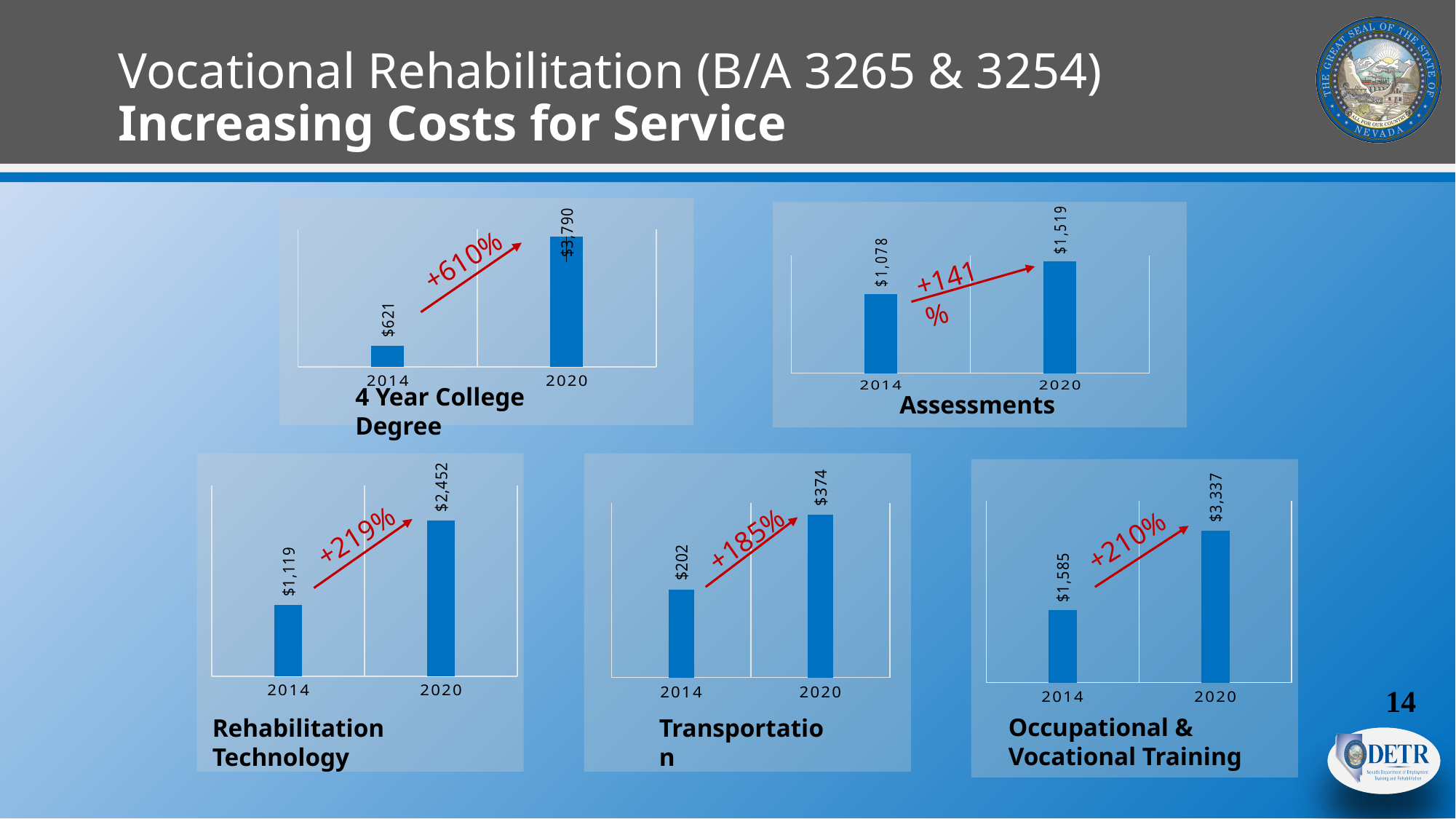
In the 4 Year College Degree chart, what is the value for 2020? $3,790 In the Rehabilitation Technology chart, do the values rise or fall from 2014 to 2020? rise In the Assessments chart, what is the difference between the 2020 and 2014 values? $441 What percentage increase is annotated on the 4 Year College Degree chart? +610% In the Assessments chart, what is the value for 2020? $1,519 In the 4 Year College Degree chart, what is the value for 2014? $621 What kind of chart is the Assessments chart? bar chart In the Occupational & Vocational Training chart, what is the value for 2014? $1,585 In the Transportation chart, what is the value for 2020? $374 In the Occupational & Vocational Training chart, what is the difference between the 2020 and 2014 values? $1,752 In the Transportation chart, which year has the higher value, 2014 or 2020? 2020 In the Rehabilitation Technology chart, what is the value for 2014? $1,119